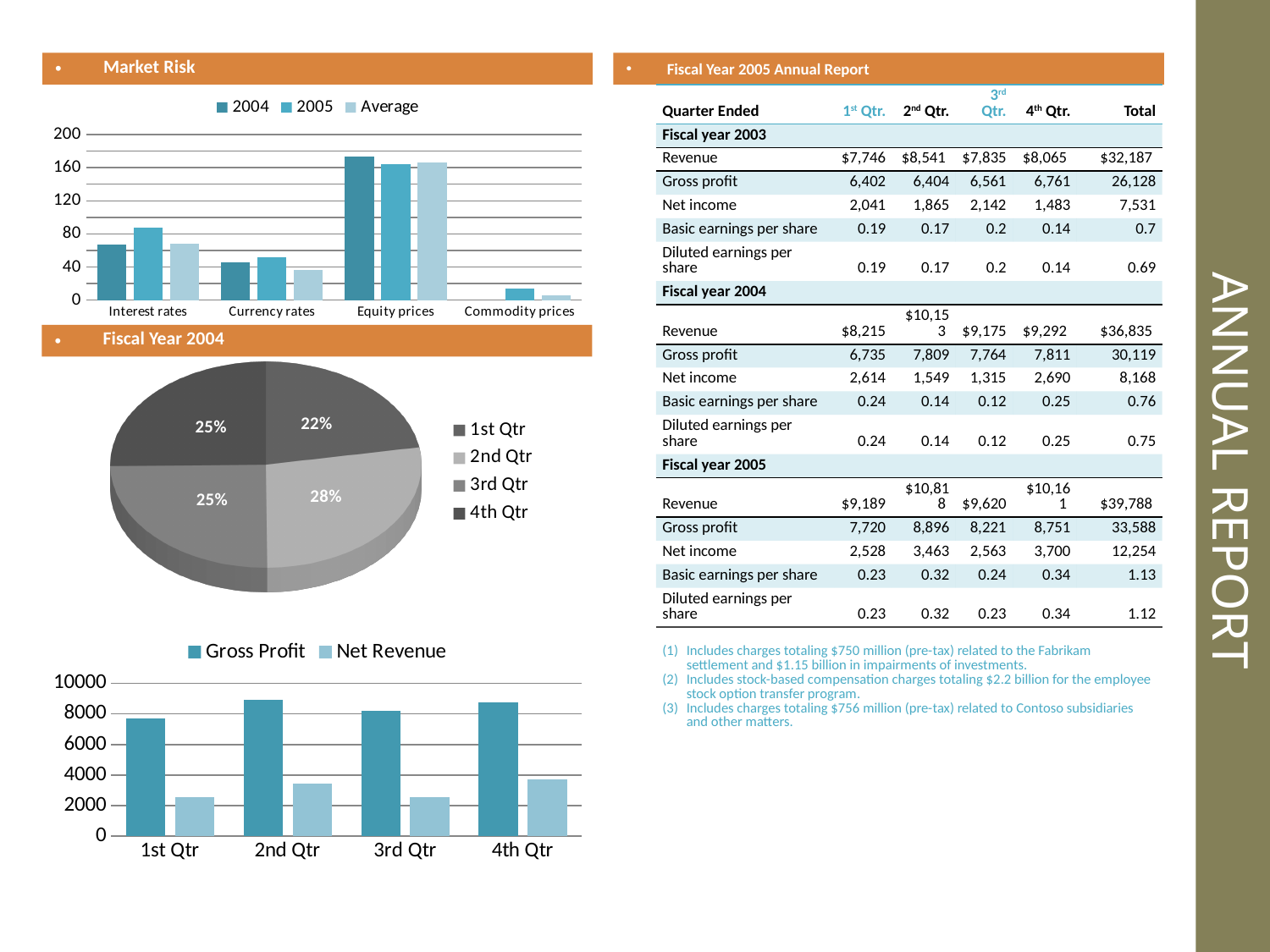
On the Market Risk chart, is the 2004 value for Currency rates greater or less than 80? less On the Market Risk chart, how many series does the legend list? 3 On the bottom-left Gross Profit / Net Revenue chart, how many quarters are shown on the x axis? 4 On the Market Risk chart, which is larger for Interest rates: the 2004 value or the 2005 value? 2005 On the Market Risk chart, which category has the lowest values? Commodity prices On the bottom-left Gross Profit / Net Revenue chart, is the Net Revenue value for 4th Qtr greater or less than 4000? less On the Fiscal Year 2004 pie chart, what share does 2nd Qtr have? 28% On the Market Risk chart, which category has the highest values? Equity prices On the Fiscal Year 2004 pie chart, which quarter has the smallest slice? 1st Qtr On the Fiscal Year 2004 pie chart, what is the difference between the 2nd Qtr and 1st Qtr shares? 6% On the Market Risk chart, is the 2005 value for Interest rates greater or less than 80? greater What kind of chart is the Fiscal Year 2004 chart? Pie chart